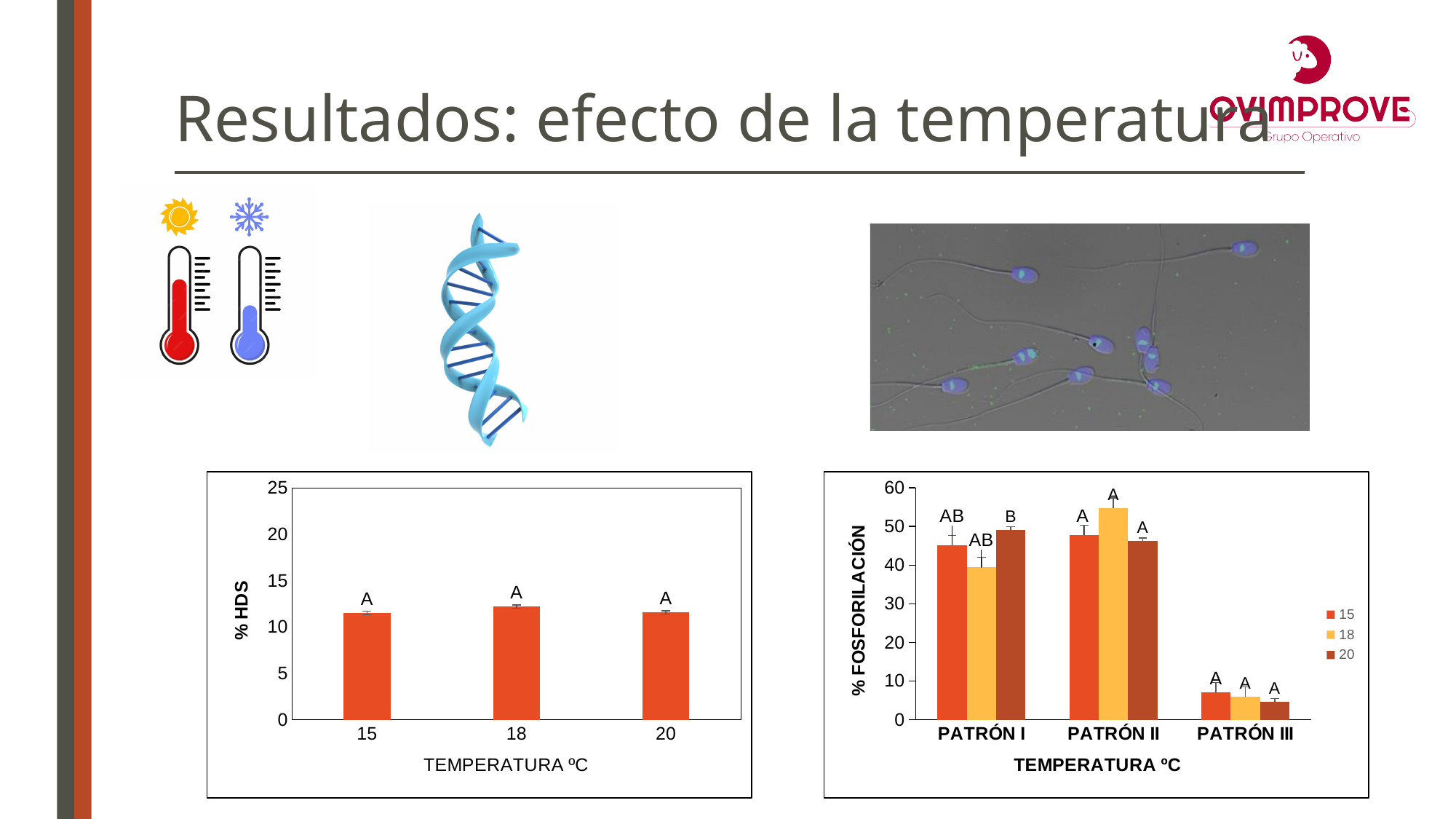
How many series does the legend of the right chart (% FOSFORILACIÓN) list? 3 In the left chart (% HDS), is the value for 15 greater or less than 15? less How many categories are shown on the x axis of the right chart (% FOSFORILACIÓN)? 3 In the right chart (% FOSFORILACIÓN), which category and series has the highest bar? PATRÓN II, 18 How many temperature categories are shown on the x axis of the left chart (% HDS)? 3 In the right chart (% FOSFORILACIÓN), for PATRÓN I, which is larger: series 18 or series 20? 20 In the right chart (% FOSFORILACIÓN), which category has the lowest bars overall? PATRÓN III In the left chart (% HDS), is the value for 18 greater or less than 10? greater What is the y-axis label of the left chart? % HDS In the right chart (% FOSFORILACIÓN), is the value for series 18 in PATRÓN II greater or less than 50? greater What kind of chart is the left chart (% HDS)? bar chart